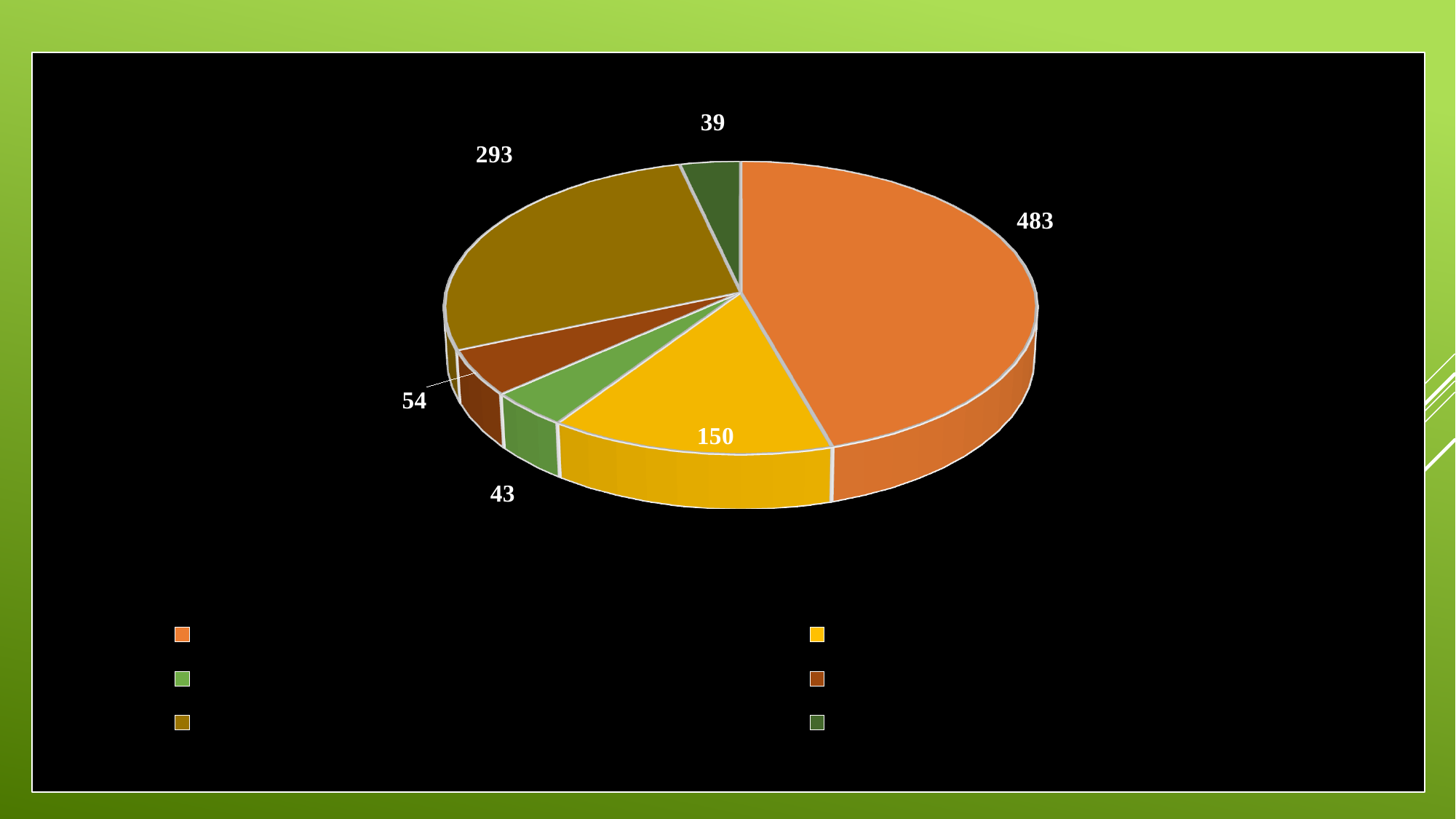
What is the difference between the slice labelled 150 and the slice labelled 43? 107 What value is labelled on the orange slice of the pie chart? 483 Which is larger, the orange slice or the dark gold slice? the orange slice What value is labelled on the yellow slice of the pie chart? 150 What is the total of all the slice values in the pie chart? 1062 What is the value of the largest slice of the pie chart? 483 What kind of chart is shown on the slide? pie chart What is the difference between the two largest slice values, 483 and 293? 190 How many slices does the pie chart have? 6 What value is labelled on the dark gold (olive) slice of the pie chart? 293 What is the value of the smallest slice of the pie chart? 39 How many colour swatches are shown in the legend below the pie chart? 6